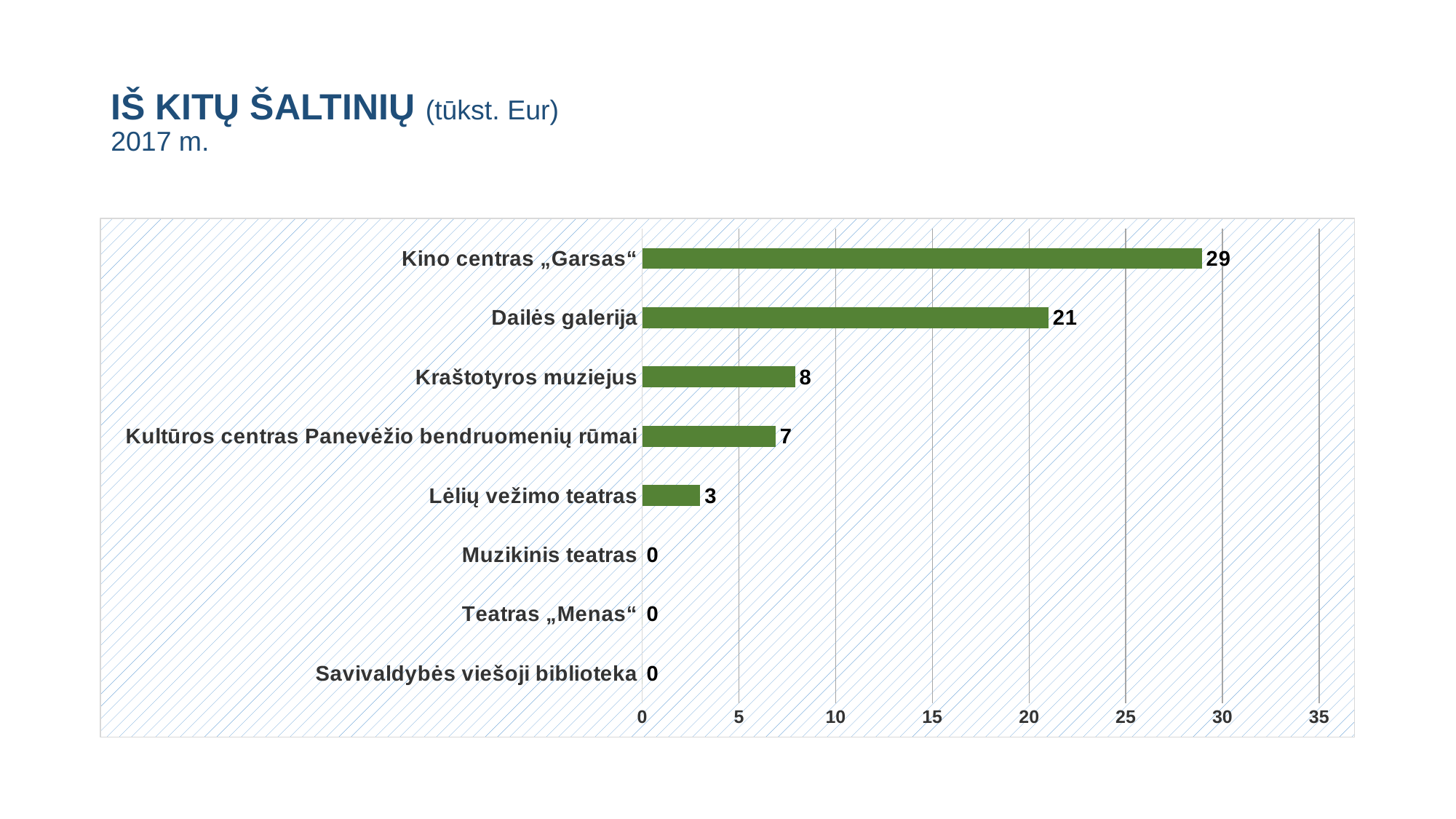
What is the value for Kraštotyros muziejus? 8 How many categories are shown on the chart? 8 What is the value for Kino centras „Garsas“? 29 How many categories have a value of 0? 3 What is the value for Dailės galerija? 21 What is the difference between the values for Kraštotyros muziejus and Kultūros centras Panevėžio bendruomenių rūmai? 1 What is the difference between the values for Kino centras „Garsas“ and Dailės galerija? 8 What is the value for Lėlių vežimo teatras? 3 What kind of chart is shown on the slide? bar chart Is the value for Dailės galerija greater or less than 25? less Which category has the highest value? Kino centras „Garsas“ Which is larger, the value for Dailės galerija or the value for Kraštotyros muziejus? Dailės galerija